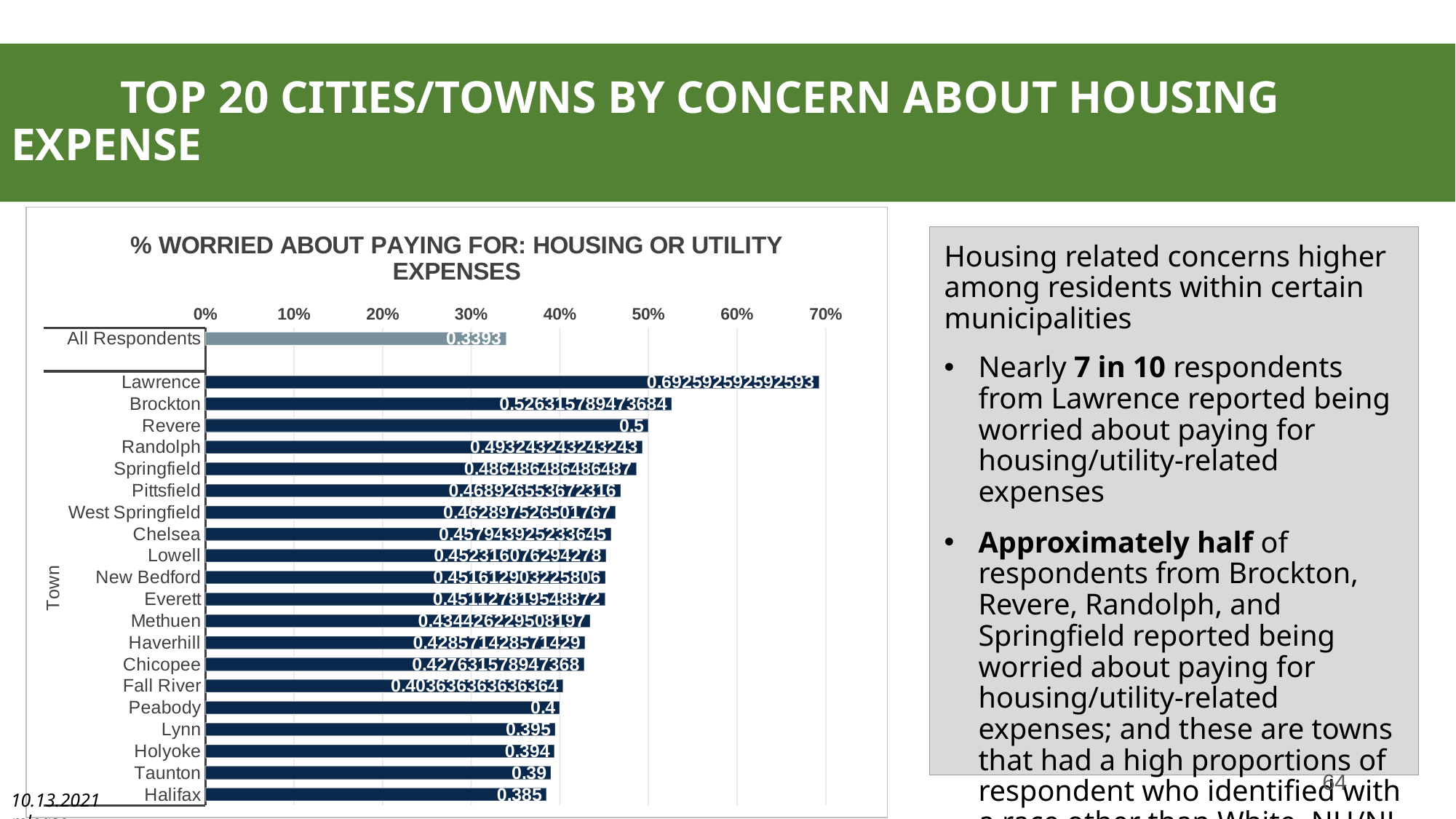
What is the value for Peabody? 0.4 Which town has the lowest value? Halifax What is the title of the chart? % WORRIED ABOUT PAYING FOR: HOUSING OR UTILITY EXPENSES What is the difference between the values for Revere and Peabody? 0.1 Is the value for Lawrence greater or less than 60%? greater Which has a larger value, Brockton or Revere? Brockton How many towns are listed in the chart, excluding All Respondents? 20 What type of chart is shown on the slide? bar chart What is the value for Lawrence? 0.692592592592593 What is the value for Revere? 0.5 What is the value for All Respondents? 0.3393 Which town has the highest value? Lawrence